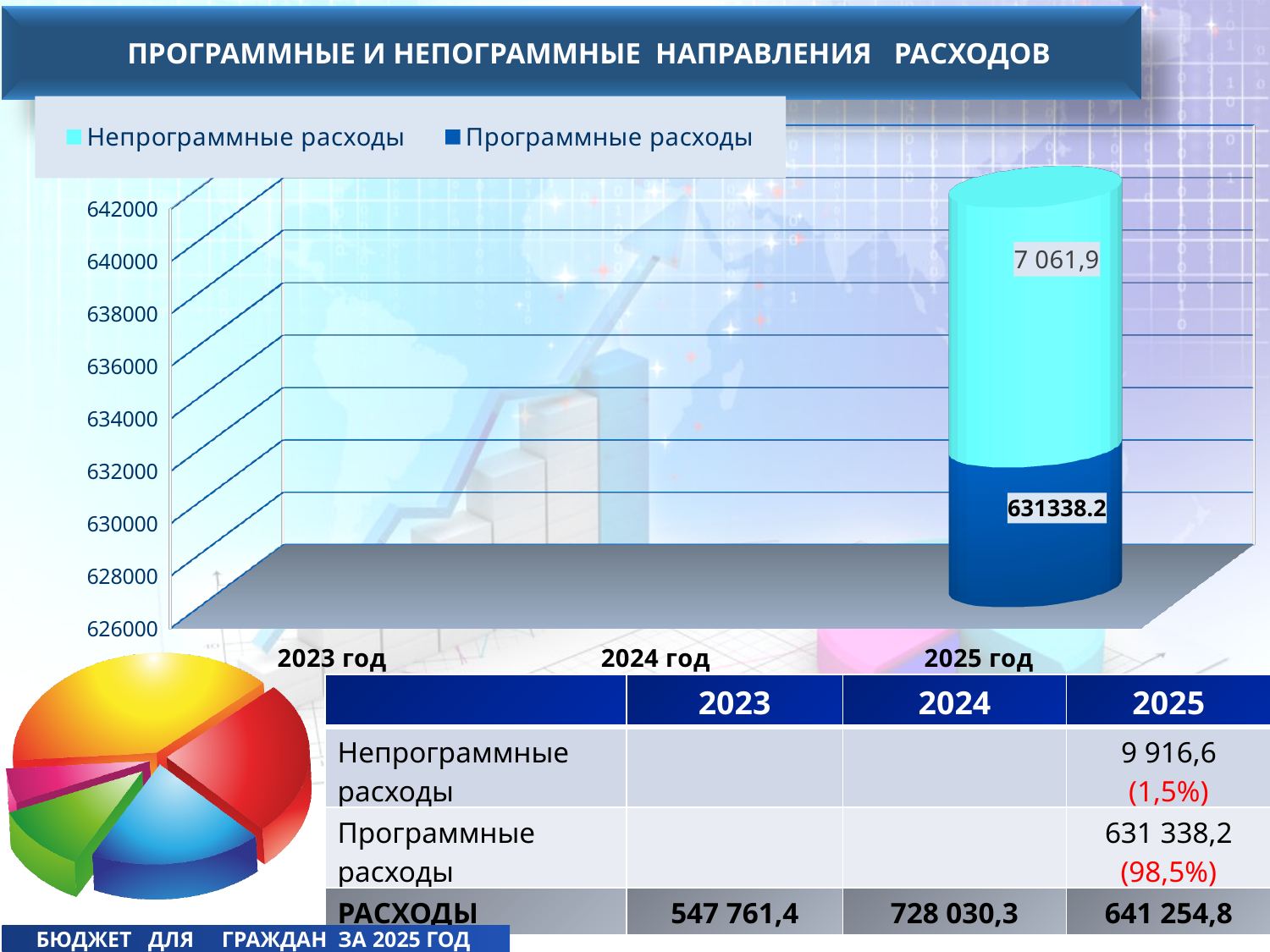
Is the value of Программные расходы for 2025 год greater or less than 630000? greater What are the two series named in the chart legend? Непрограммные расходы and Программные расходы Which category on the x axis has a bar plotted in the chart? 2025 год What is the lowest value shown on the chart's vertical axis? 626000 What is the highest value shown on the chart's vertical axis? 642000 What is the value of Программные расходы for 2025 год in the chart? 631338.2 In the 2025 год bar, which series has the larger value, Программные расходы or Непрограммные расходы? Программные расходы How many categories are shown along the x axis of the chart? 3 What kind of chart is shown on the slide? Stacked bar chart How many series does the chart legend list? 2